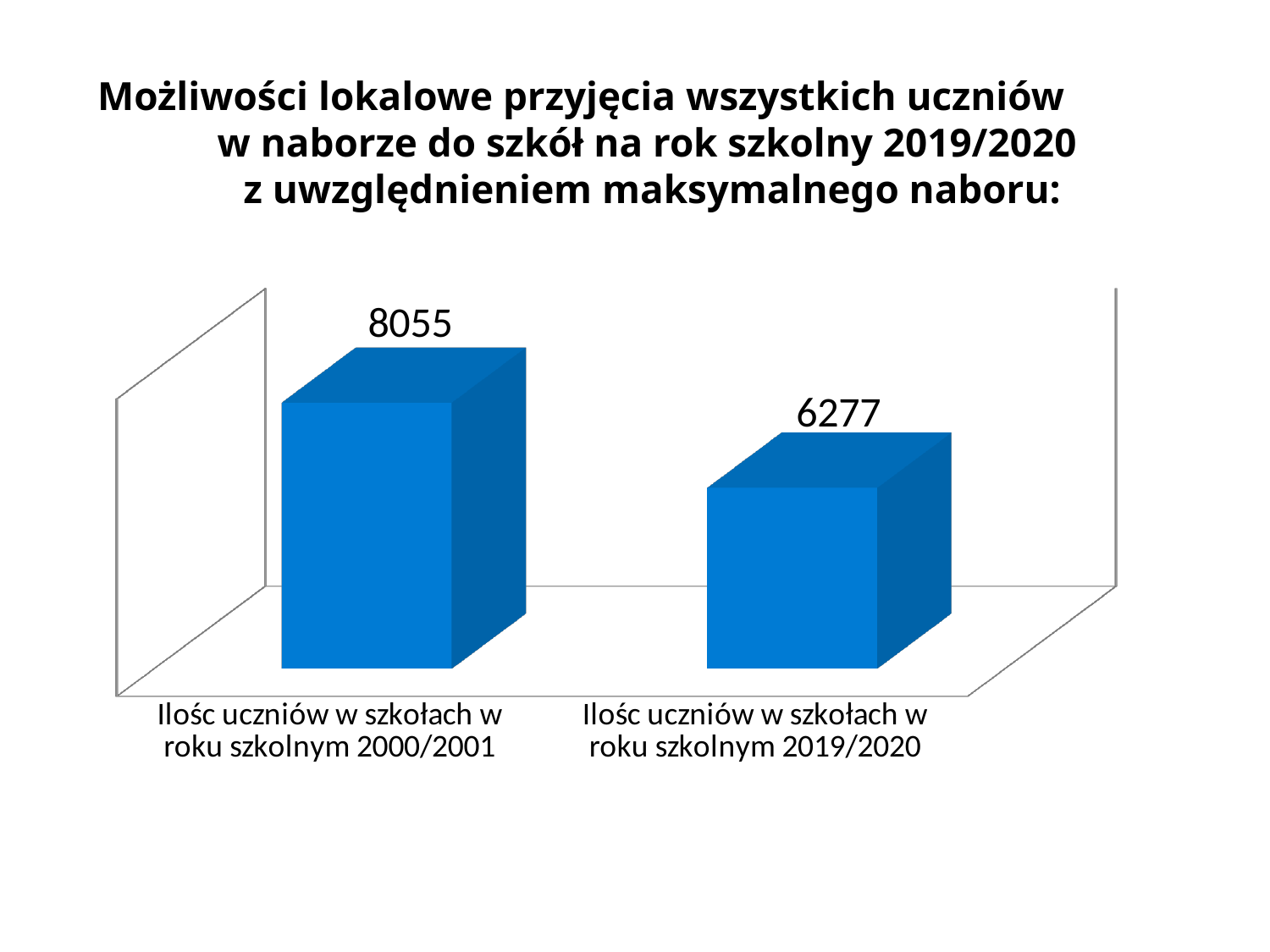
What school year does the title say the enrolment refers to? 2019/2020 Which category has the highest value? Ilość uczniów w szkołach w roku szkolnym 2000/2001 What colour are the bars in the chart? Blue Which category has the lowest value? Ilość uczniów w szkołach w roku szkolnym 2019/2020 Which is larger: the value for 2000/2001 or the value for 2019/2020? 2000/2001 How many categories are shown in the chart? 2 What is the value for 'Ilość uczniów w szkołach w roku szkolnym 2019/2020'? 6277 Do the values rise or fall from the left category to the right category? Fall What kind of chart is shown on the slide? Bar chart What is the value for 'Ilość uczniów w szkołach w roku szkolnym 2000/2001'? 8055 What is the difference between the value for 2000/2001 and the value for 2019/2020? 1778